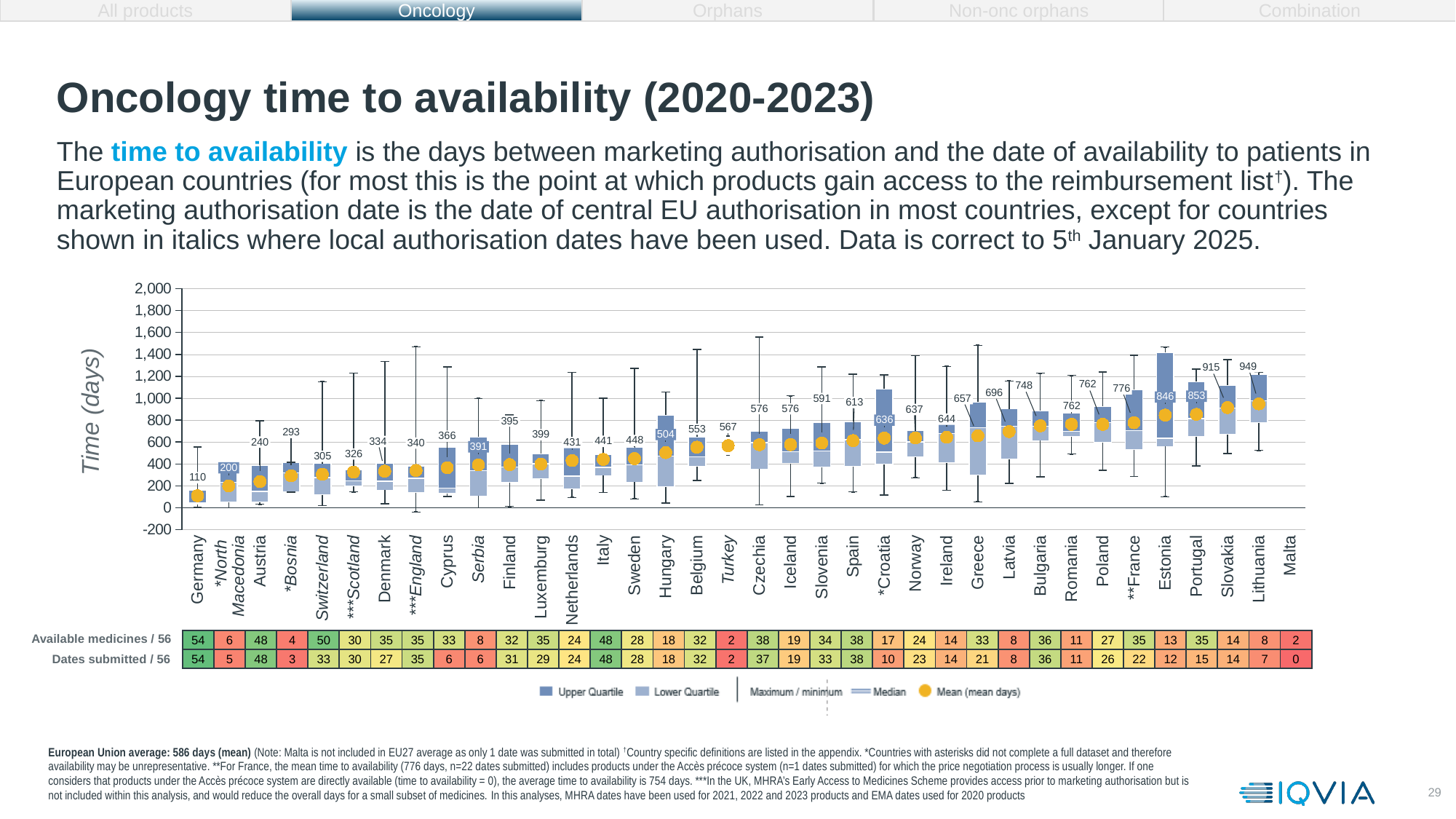
Which country has the lowest labelled mean time to availability? Germany What kind of chart is used to show time to availability by country? Box plot (box-and-whisker chart) Which has the larger labelled mean time to availability, Belgium or Hungary? Belgium What is the mean time to availability (in days) shown for Germany? 110 Which country has the highest labelled mean time to availability? Lithuania What mean value is labelled for **France? 776 What is the mean time to availability shown for Lithuania? 949 Is the maximum whisker value for Czechia greater or less than 1,400? greater What is the difference between the labelled mean for Lithuania and the labelled mean for Germany? 839 How many countries are listed along the x axis of the chart? 36 What is the label on the y axis of the chart? Time (days) Do the labelled mean values generally rise or fall moving from left to right along the x axis? Rise